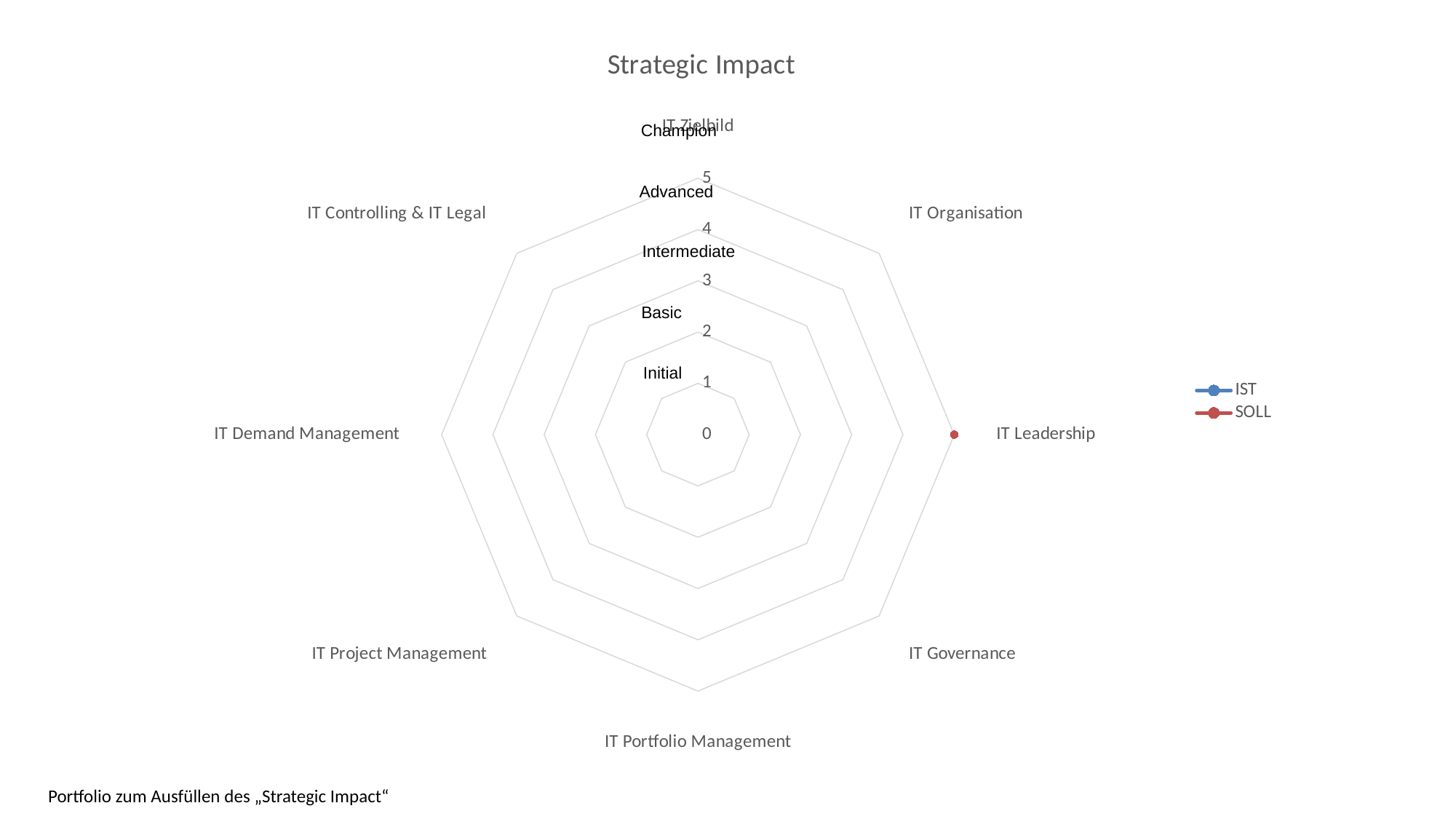
Which category label appears at the bottom of the radar chart? IT Portfolio Management How many series does the legend list? 2 What is the maximum value shown on the radar chart's axis scale? 5 What are the two series named in the legend? IST and SOLL What kind of chart is shown on the slide? Radar chart Is the SOLL value for IT Leadership greater or less than 3? greater For which category is a SOLL data point plotted? IT Leadership How many categories (axes) does the radar chart have? 8 What is the SOLL value for IT Leadership? 5